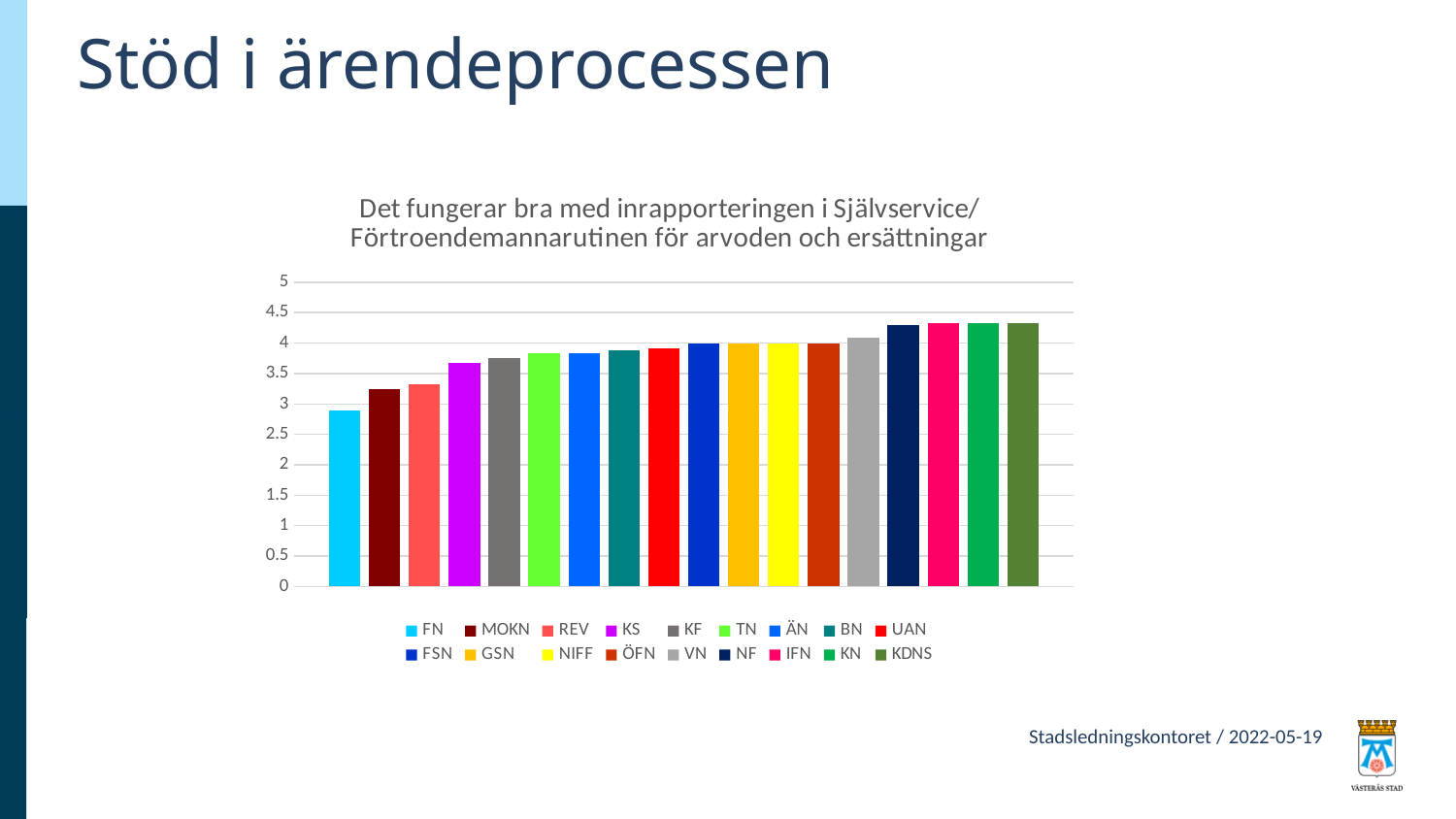
What is the title of the chart? Det fungerar bra med inrapporteringen i Självservice/ Förtroendemannarutinen för arvoden och ersättningar How many entries does the chart's legend list? 18 Which has the larger value, MOKN or VN? VN Which category has the lowest value in the chart? FN Is the value for FN greater or less than 3? less Do the bar values generally rise or fall from left to right across the chart? Rise What kind of chart is shown on the slide? Bar chart Is the value for REV greater or less than 3.5? less How many bars are plotted in the chart? 18 Is the value for KS greater or less than 3.5? greater